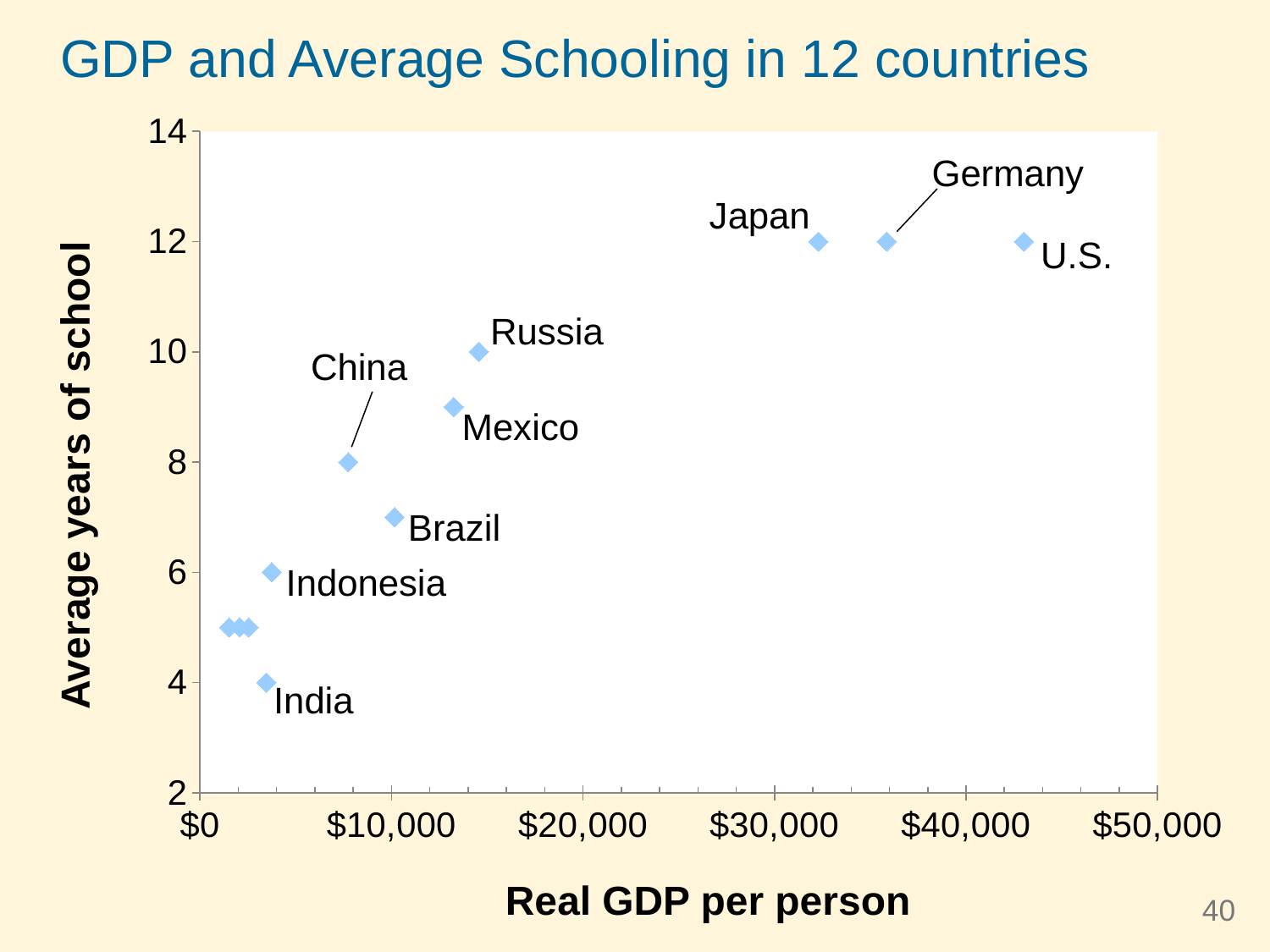
Is the real GDP per person for the U.S. greater or less than $40,000? greater What is the difference in average years of school between Japan and India? 8 What kind of chart is shown on the slide? scatter chart What is the average years of school for India? 4 What is the average years of school for China? 8 What is the title of the x axis? Real GDP per person As real GDP per person increases along the x axis, do average years of school generally rise or fall? rise Which labeled country has the lowest average years of school? India Is the real GDP per person for Mexico greater or less than $20,000? less Which has more average years of school, Russia or Brazil? Russia What is the average years of school for Russia? 10 What is the average years of school for Japan? 12